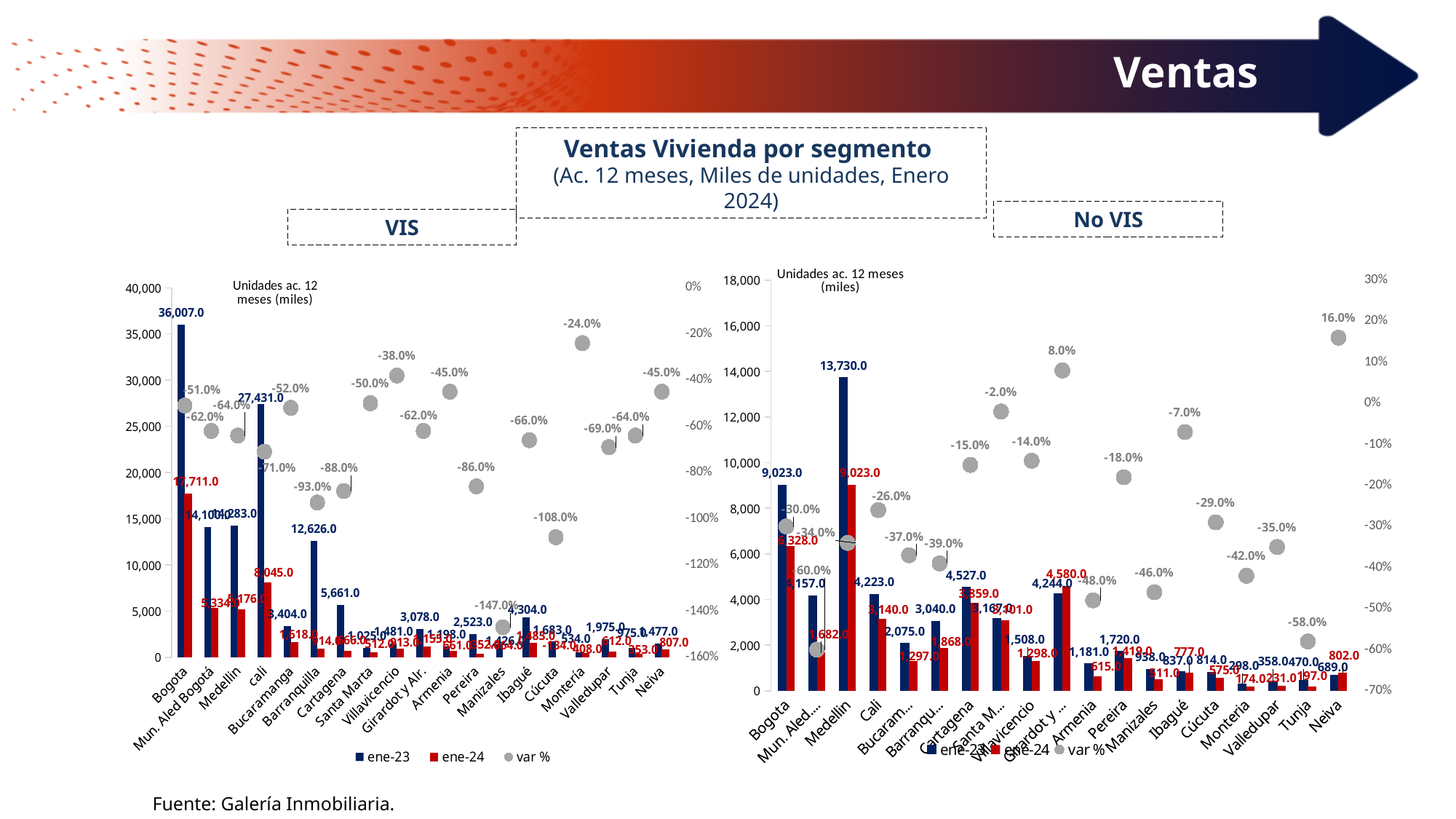
In the No VIS chart, which city has the highest ene-23 value? Medellin In the VIS chart, which city has the highest ene-23 value? Bogota In the No VIS chart, which is larger for Girardot y ..., the ene-23 value or the ene-24 value? ene-24 In the No VIS chart, what is the difference between the ene-23 and ene-24 values for Cartagena? 668.0 In the VIS chart, what is the ene-24 value for cali? 8,045.0 In the VIS chart, what is the var % for Barranquilla? -93.0% In the VIS chart, what is the difference between the ene-23 and ene-24 values for Bogota? 18,296.0 How many series does the legend of the VIS chart list? 3 In the No VIS chart, what is the ene-23 value for Medellin? 13,730.0 In the VIS chart, what is the ene-23 value for Bogota? 36,007.0 In the No VIS chart, what is the var % for Neiva? 16.0% What kind of chart is the No VIS chart? Bar chart with a line/dot series for var %